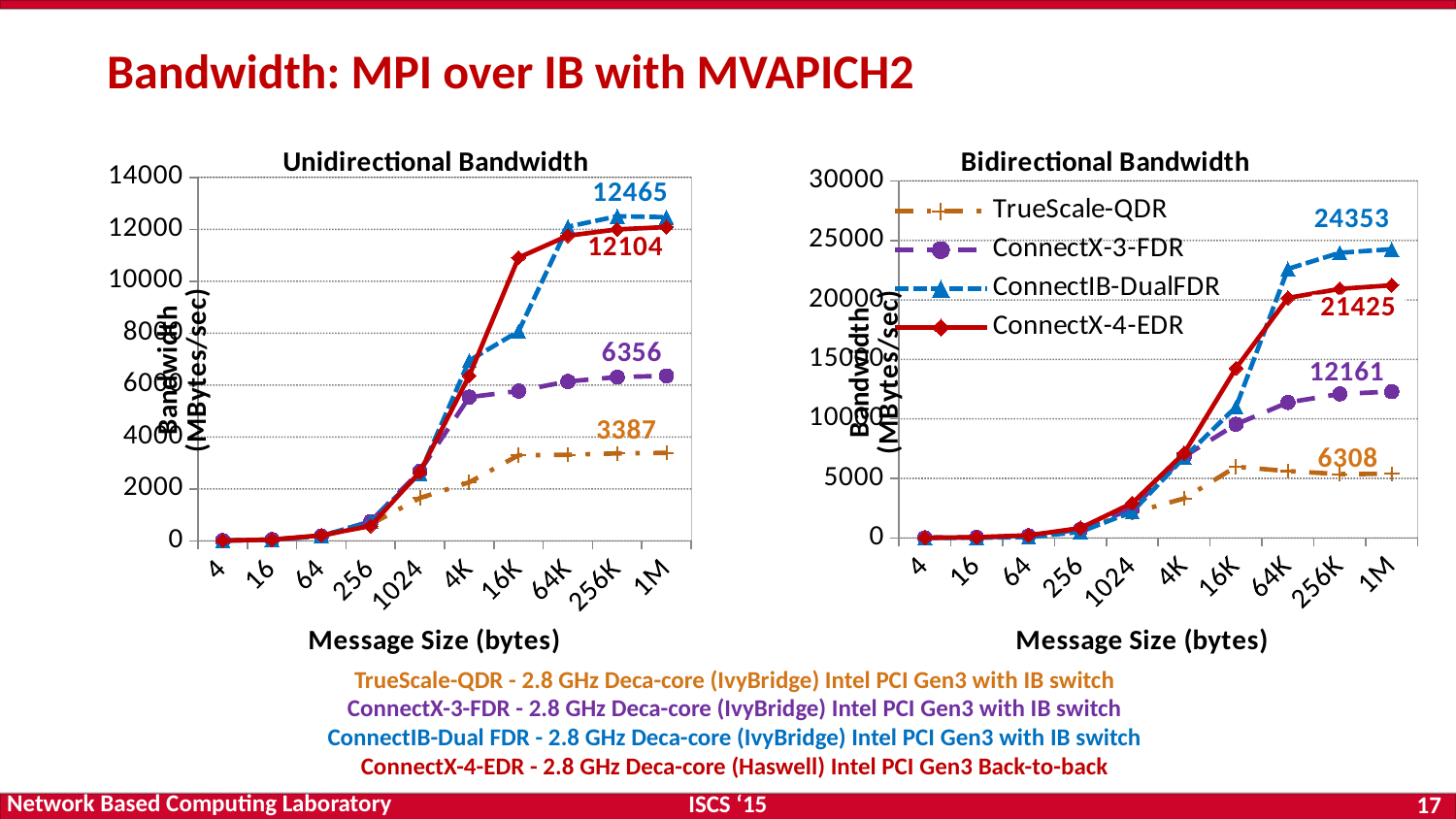
In the Bidirectional Bandwidth chart, which series reaches the highest labelled bandwidth? ConnectIB-DualFDR How many series does the legend on the Bidirectional Bandwidth chart list? 4 What kind of chart is the Unidirectional Bandwidth chart? Line chart In the Bidirectional Bandwidth chart, what is the difference between the labelled peak values of ConnectIB-DualFDR and ConnectX-4-EDR? 2928 In the Unidirectional Bandwidth chart, what peak bandwidth value is labelled for ConnectIB-DualFDR? 12465 In the Unidirectional Bandwidth chart, which series has the lowest labelled peak bandwidth? TrueScale-QDR In the Bidirectional Bandwidth chart, what peak bandwidth value is labelled for ConnectX-3-FDR? 12161 How many message-size categories are shown on the x axis of the Unidirectional Bandwidth chart? 10 In the Bidirectional Bandwidth chart, is the value for ConnectX-4-EDR at message size 1M greater or less than 20000? greater In the Bidirectional Bandwidth chart, what peak bandwidth value is labelled for TrueScale-QDR? 6308 In the Unidirectional Bandwidth chart, which has a higher labelled peak value: ConnectX-3-FDR or TrueScale-QDR? ConnectX-3-FDR In the Unidirectional Bandwidth chart, what peak bandwidth value is labelled for ConnectX-4-EDR? 12104